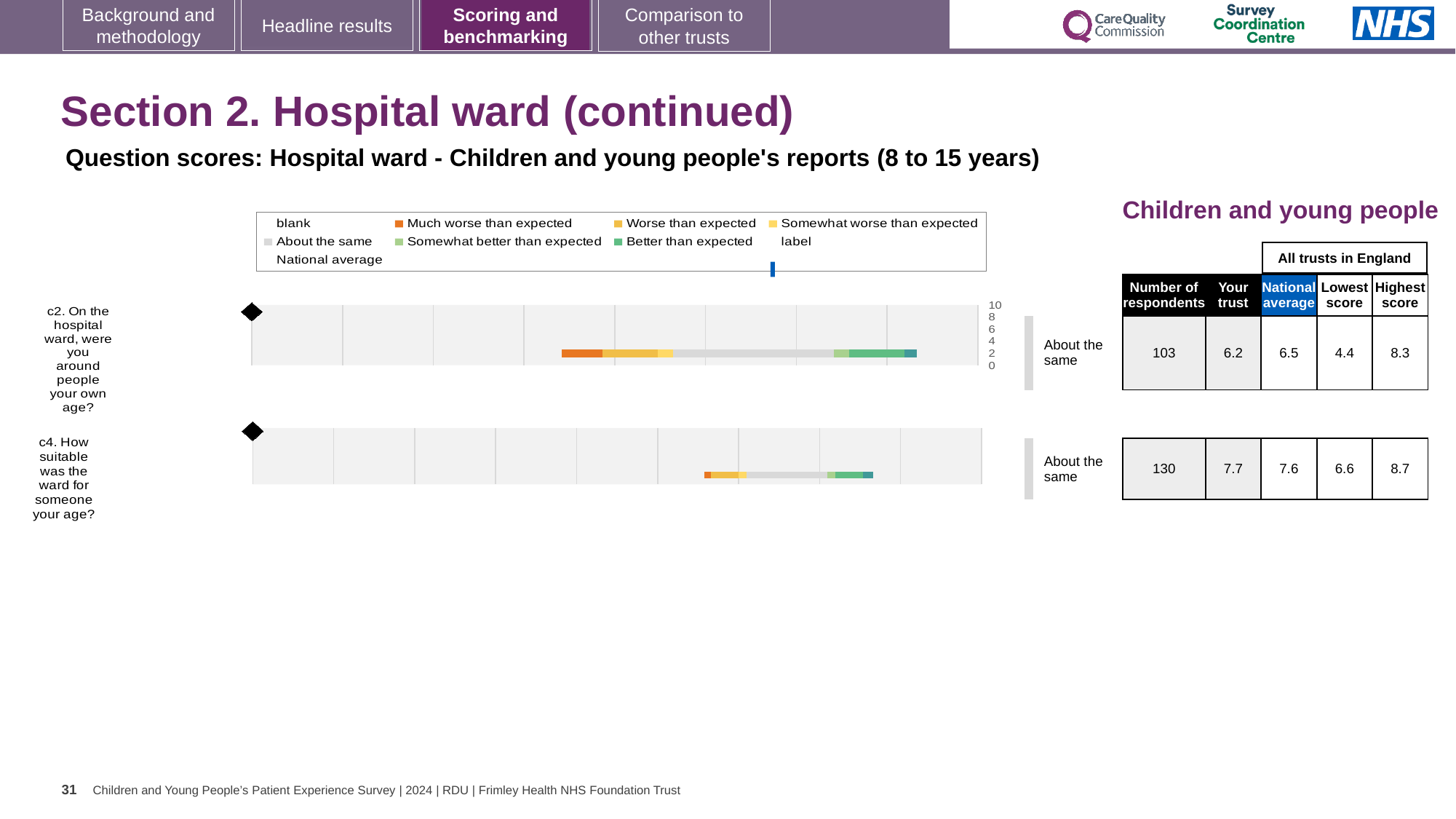
What is the 'Your trust' score for question c2 (On the hospital ward, were you around people your own age?)? 6.2 In the chart legend, which entry is shown by the blue marker? National average How many respondents answered question c4? 130 For question c4, how much higher is the 'Your trust' score than the national average? 0.1 What kind of chart is used to show the question scores for c2 and c4? bar chart How many questions are plotted on the slide? 2 What is the 'Your trust' score for question c4 (How suitable was the ward for someone your age?)? 7.7 What is the difference between the highest score and the lowest score for question c2? 3.9 Which question has the higher 'Your trust' score, c2 or c4? c4 In the chart legend, what colour represents 'Much worse than expected'? orange What is the national average score for question c2? 6.5 What benchmark category is given for question c2? About the same